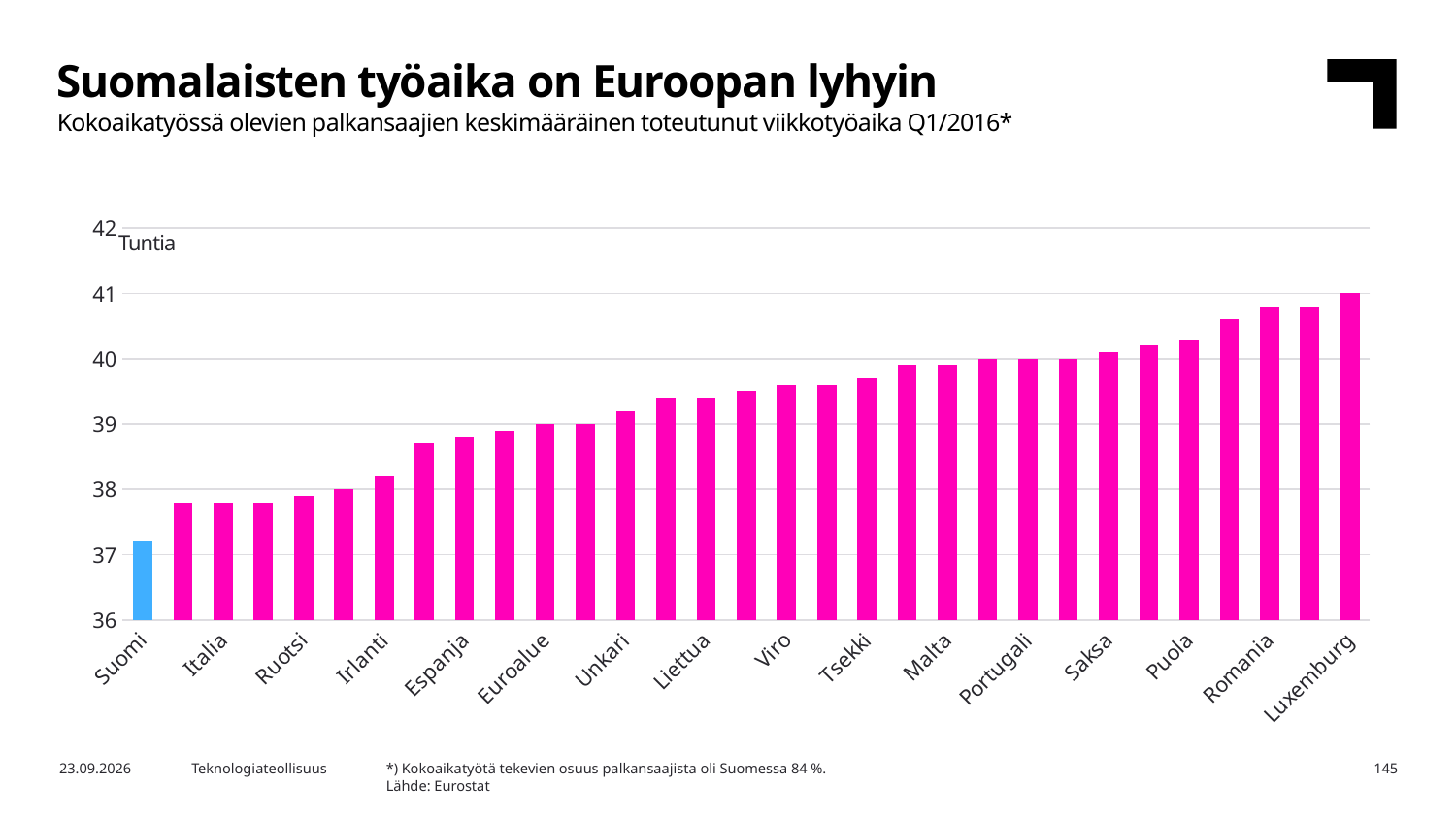
What kind of chart is shown on the slide? bar chart Is the value for Suomi greater or less than 38? less Which is larger, the value for Romania or the value for Italia? Romania What is the value for Euroalue in hours? 39 Is the value for Romania greater or less than 40? greater Which country has the highest average weekly working time in the chart? Luxemburg What is the value for Luxemburg in hours? 41 Do the values rise or fall moving from left to right along the x axis? rise Which bar is coloured differently (blue) from the other bars? Suomi Is the value for Viro greater or less than 40? less Which country has the lowest average weekly working time in the chart? Suomi